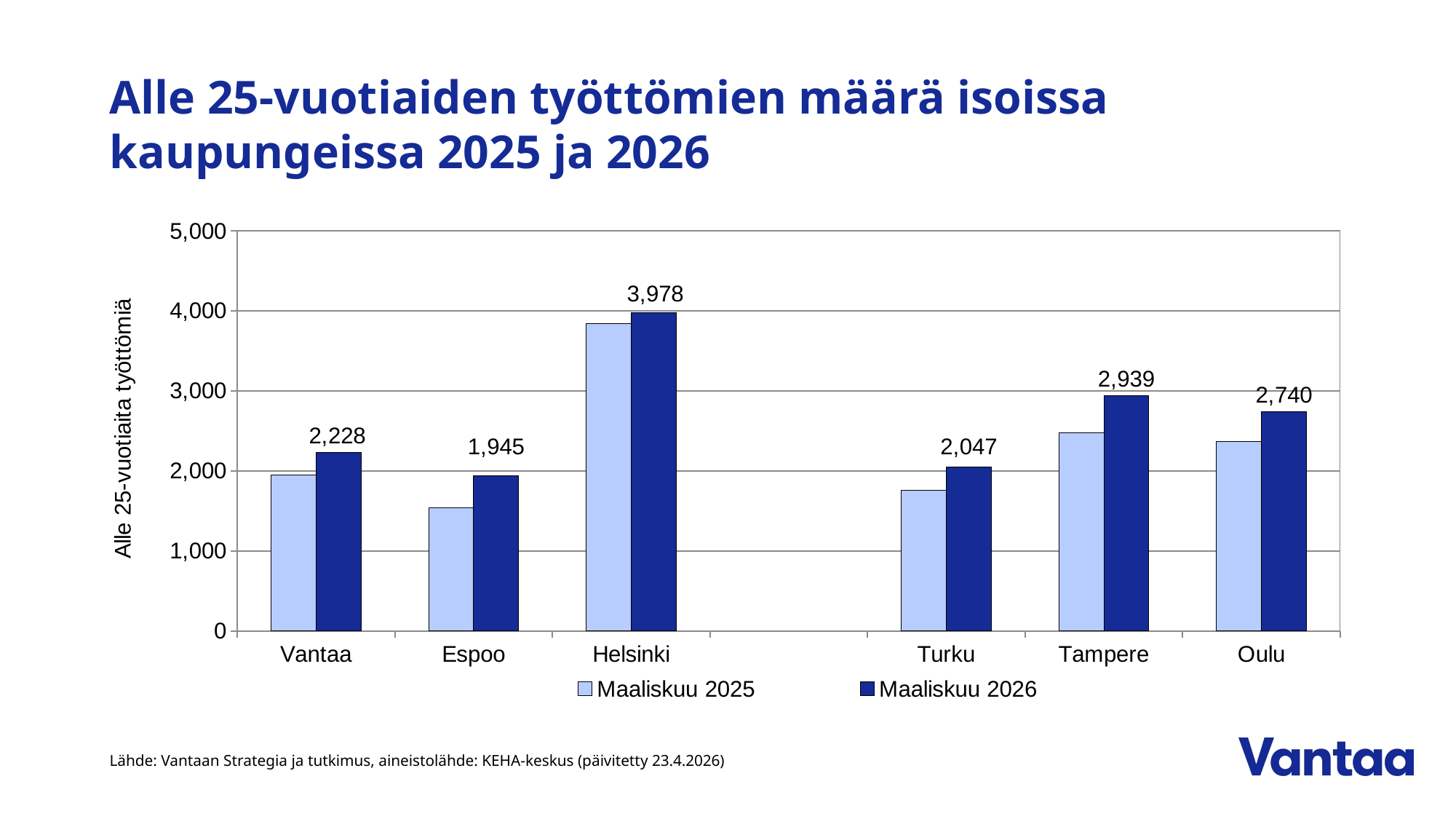
Is the Maaliskuu 2025 value for Espoo greater or less than 2,000? less How many cities are shown on the x axis? 6 What is the value for Vantaa in the Maaliskuu 2026 series? 2,228 Which city has the highest value in the Maaliskuu 2026 series? Helsinki Which city has the lowest value in the Maaliskuu 2026 series? Espoo What is the difference between the Maaliskuu 2026 values for Tampere and Oulu? 199 What is the value for Oulu in the Maaliskuu 2026 series? 2,740 What kind of chart is shown on the slide? Bar chart What is the value for Helsinki in the Maaliskuu 2026 series? 3,978 How many series does the legend list? 2 Is the Maaliskuu 2025 value for Helsinki greater or less than 3,000? greater Which is larger in the Maaliskuu 2026 series: Vantaa or Turku? Vantaa